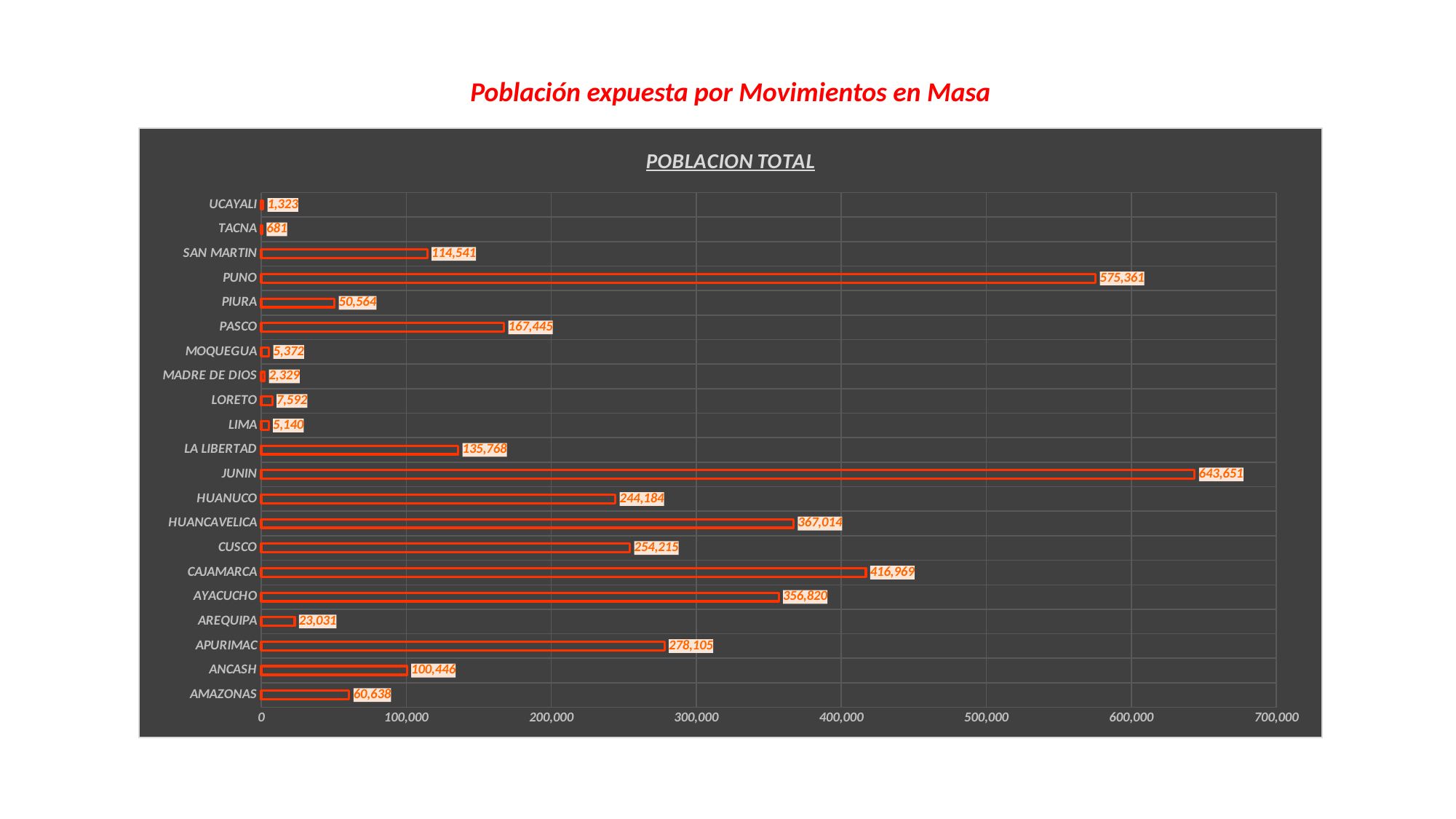
What is the value for PUNO in the POBLACION TOTAL chart? 575,361 What is the title of the chart inside the dark panel? POBLACION TOTAL What is the difference between the values for CAJAMARCA and HUANCAVELICA? 49,955 What is the value for HUANCAVELICA? 367,014 Is the value for PASCO greater or less than 100,000? greater Which region has the highest value in the chart? JUNIN What is the value for AMAZONAS? 60,638 Which region has the lowest value in the chart? TACNA What kind of chart is shown on the slide? bar chart Which has a larger value, APURIMAC or CUSCO? APURIMAC How many regions are shown in the chart? 21 What is the difference between the values for JUNIN and PUNO? 68,290